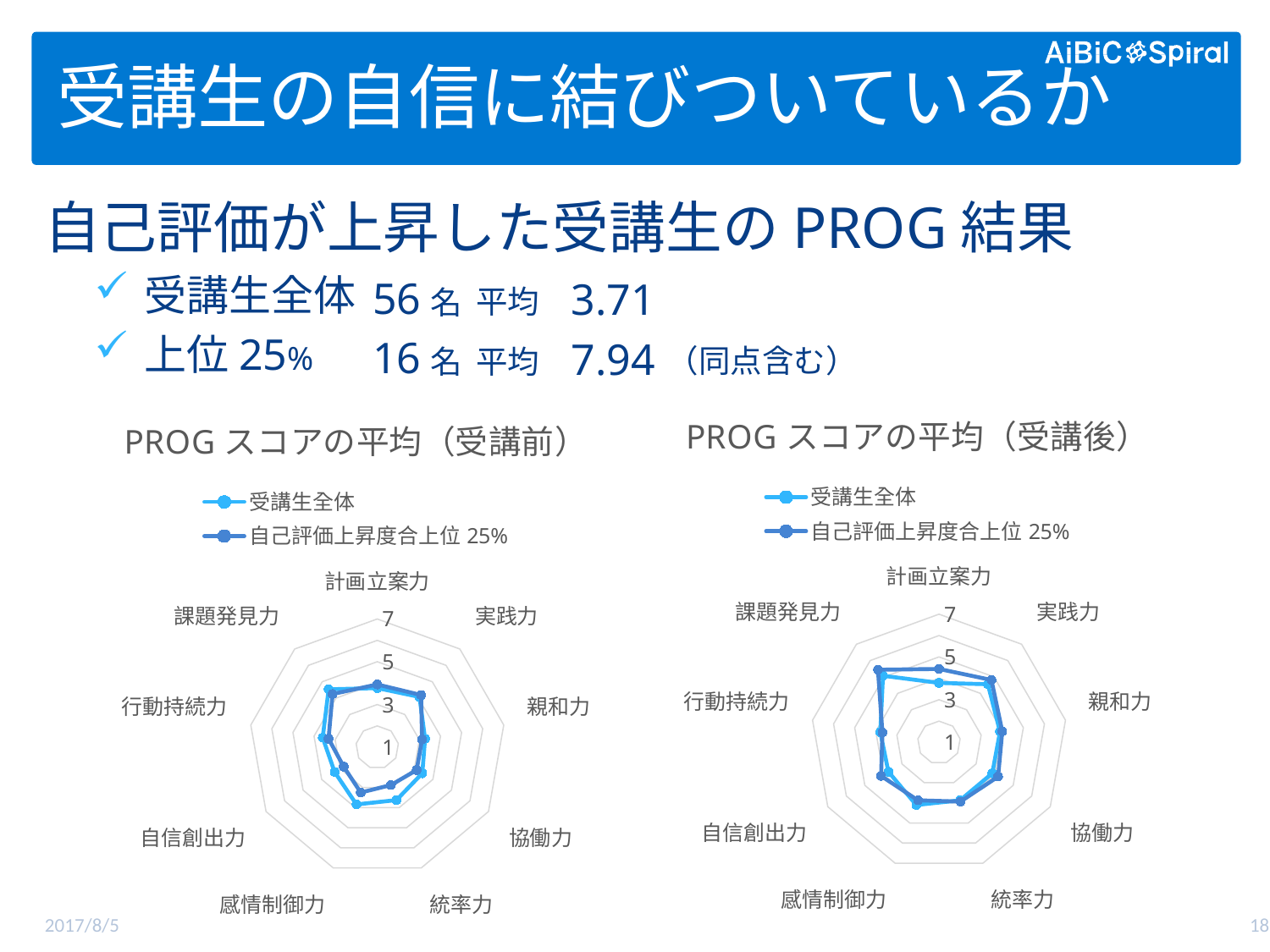
What is the title of the chart on the right side of the slide? PROG スコアの平均（受講後） In the left chart titled PROG スコアの平均（受講前）, is the value of 受講生全体 for 計画立案力 greater or less than 5? less In the right chart titled PROG スコアの平均（受講後）, is the value of 受講生全体 for 協働力 greater or less than 5? less What kind of chart is the left chart titled PROG スコアの平均（受講前）? radar chart What are the two series named in the legend of the right chart titled PROG スコアの平均（受講後）? 受講生全体 and 自己評価上昇度合上位 25% In the left chart titled PROG スコアの平均（受講前）, is the value of 受講生全体 for 親和力 greater or less than 5? less How many series does the legend of the left chart titled PROG スコアの平均（受講前） list? 2 How many categories (axes) does the right chart titled PROG スコアの平均（受講後） have? 9 How many radar charts are shown on the slide? 2